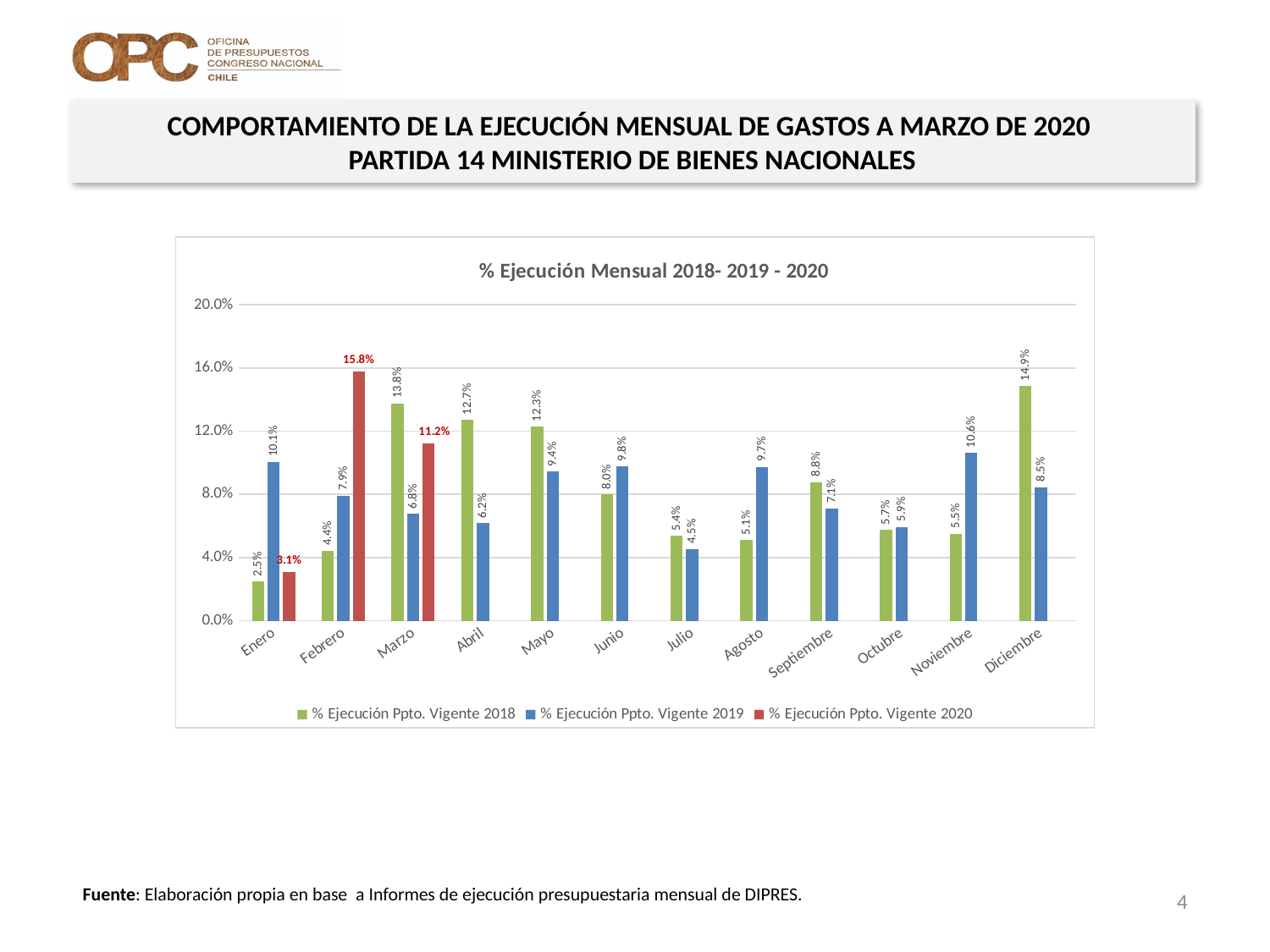
How many months are shown on the x axis? 12 What is the value for % Ejecución Ppto. Vigente 2020 in Enero? 3.1% Which month has the highest value for % Ejecución Ppto. Vigente 2018? Diciembre What is the value for % Ejecución Ppto. Vigente 2018 in Marzo? 13.8% In Agosto, which series has the larger value, 2018 or 2019? % Ejecución Ppto. Vigente 2019 Which month has the lowest value for % Ejecución Ppto. Vigente 2019? Julio How many series does the legend list? 3 What kind of chart is shown on the slide? Bar chart What is the value for % Ejecución Ppto. Vigente 2019 in Noviembre? 10.6% What is the value for % Ejecución Ppto. Vigente 2020 in Febrero? 15.8% What is the title of the chart? % Ejecución Mensual 2018- 2019 - 2020 What is the difference between the 2020 and 2019 values in Marzo? 4.4%